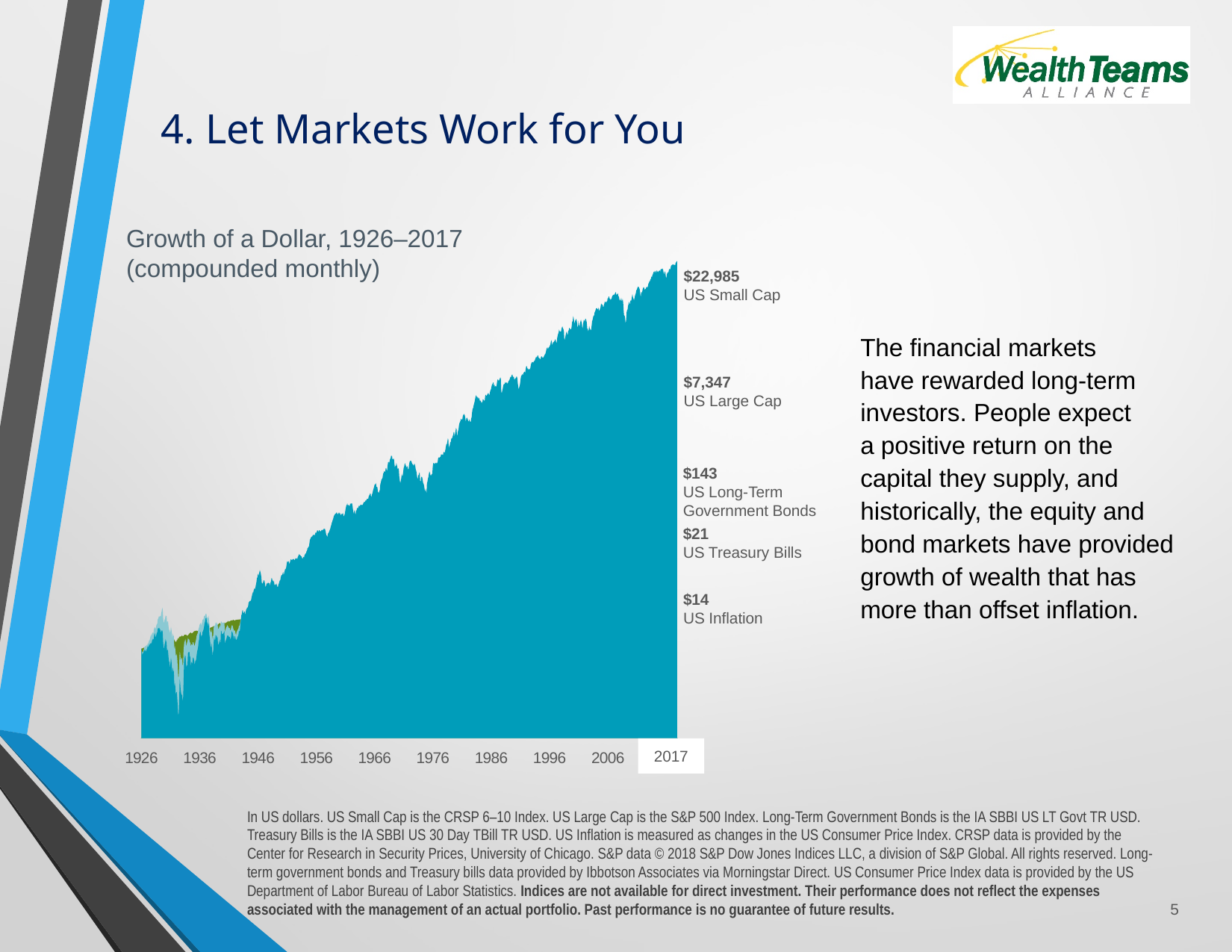
Which series has the lowest 2017 value in the chart? US Inflation Which has a larger 2017 value, US Long-Term Government Bonds or US Treasury Bills? US Long-Term Government Bonds What is the 2017 value shown for US Inflation? $14 What is the 2017 value shown for US Long-Term Government Bonds? $143 What is the title of the chart? Growth of a Dollar, 1926–2017 (compounded monthly) What is the difference between the 2017 values for US Treasury Bills and US Inflation? $7 How many series are labelled with 2017 values in the chart? 5 Which series has the highest 2017 value in the chart? US Small Cap What is the 2017 value shown for US Treasury Bills? $21 What is the 2017 value shown for US Large Cap? $7,347 What is the difference between the 2017 values for US Small Cap and US Large Cap? $15,638 What is the 2017 value shown for US Small Cap in the Growth of a Dollar chart? $22,985